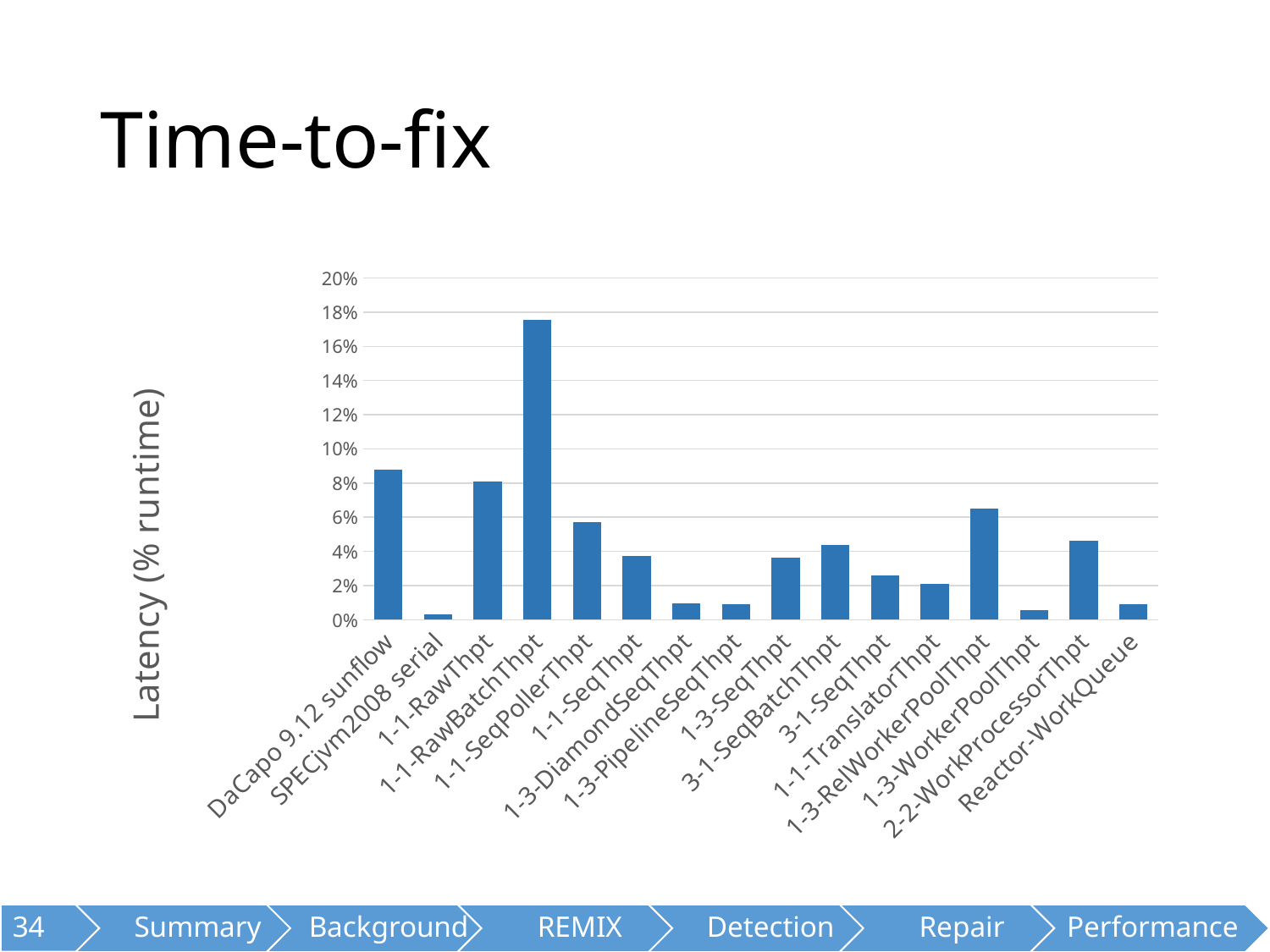
Is the value for 1-1-RawBatchThpt greater or less than 16%? greater What kind of chart is shown on the slide? bar chart Is the value for 1-3-DiamondSeqThpt greater or less than 2%? less What is the label of the vertical axis of the chart? Latency (% runtime) Is the value for 1-3-RelWorkerPoolThpt greater or less than 6%? greater How many categories are plotted on the x axis of the chart? 16 Which category has the highest latency in the chart? 1-1-RawBatchThpt What is the title of the slide containing the chart? Time-to-fix Which is larger, the value for 1-3-RelWorkerPoolThpt or the value for 2-2-WorkProcessorThpt? 1-3-RelWorkerPoolThpt Which is larger, the value for 1-1-RawThpt or the value for 1-1-SeqThpt? 1-1-RawThpt